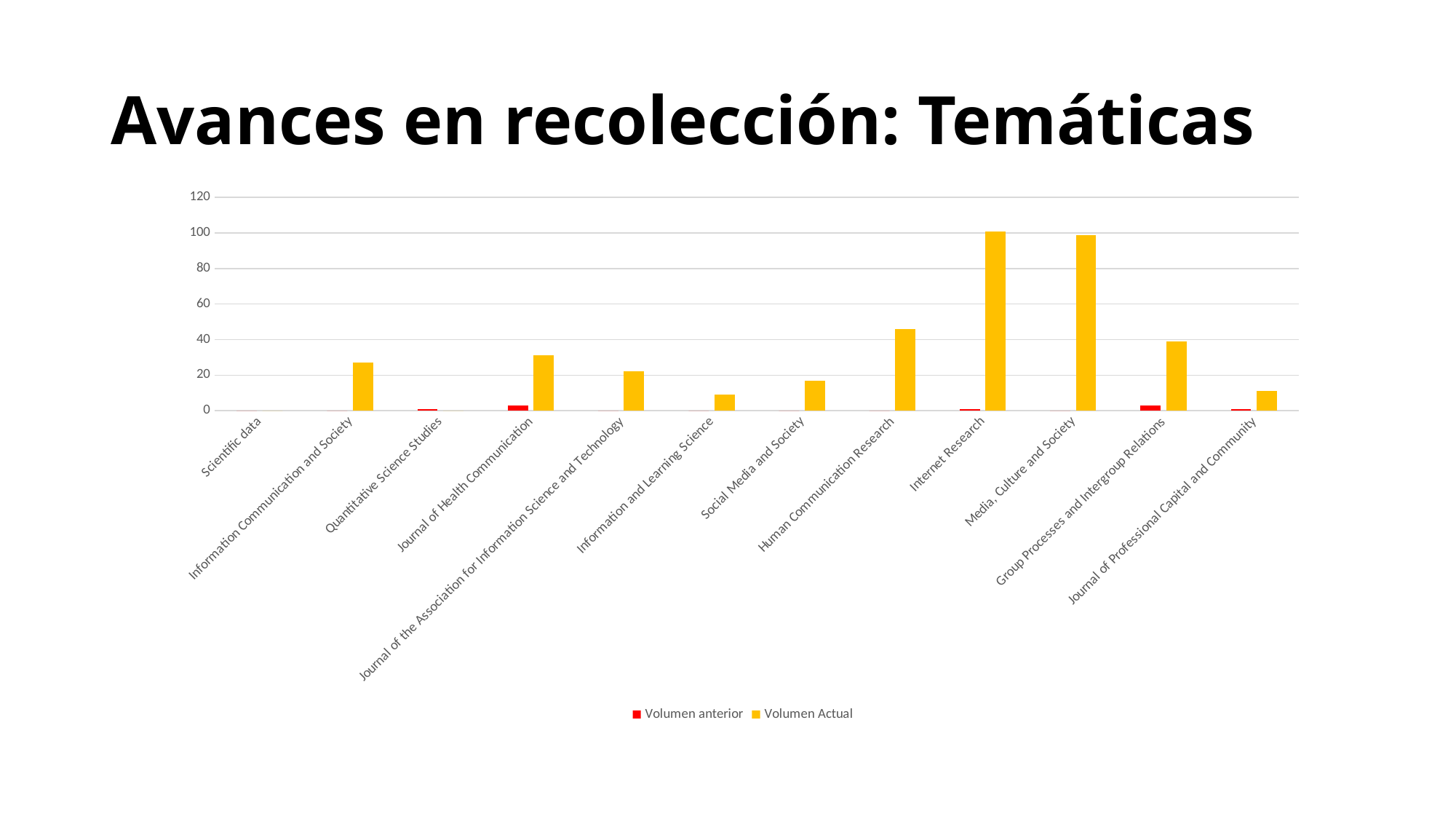
Is the Volumen Actual value for Information and Learning Science greater or less than 20? less What kind of chart is shown on the slide? bar chart Is the Volumen Actual value for Journal of Health Communication greater or less than 20? greater Which has a larger Volumen Actual value: Human Communication Research or Group Processes and Intergroup Relations? Human Communication Research Is the Volumen Actual value for Journal of Professional Capital and Community greater or less than 20? less How many series does the legend list? 2 Which has a larger Volumen Actual value: Internet Research or Information Communication and Society? Internet Research What is the title of the slide? Avances en recolección: Temáticas Which series is shown in red in the legend? Volumen anterior How many categories are shown on the x axis? 12